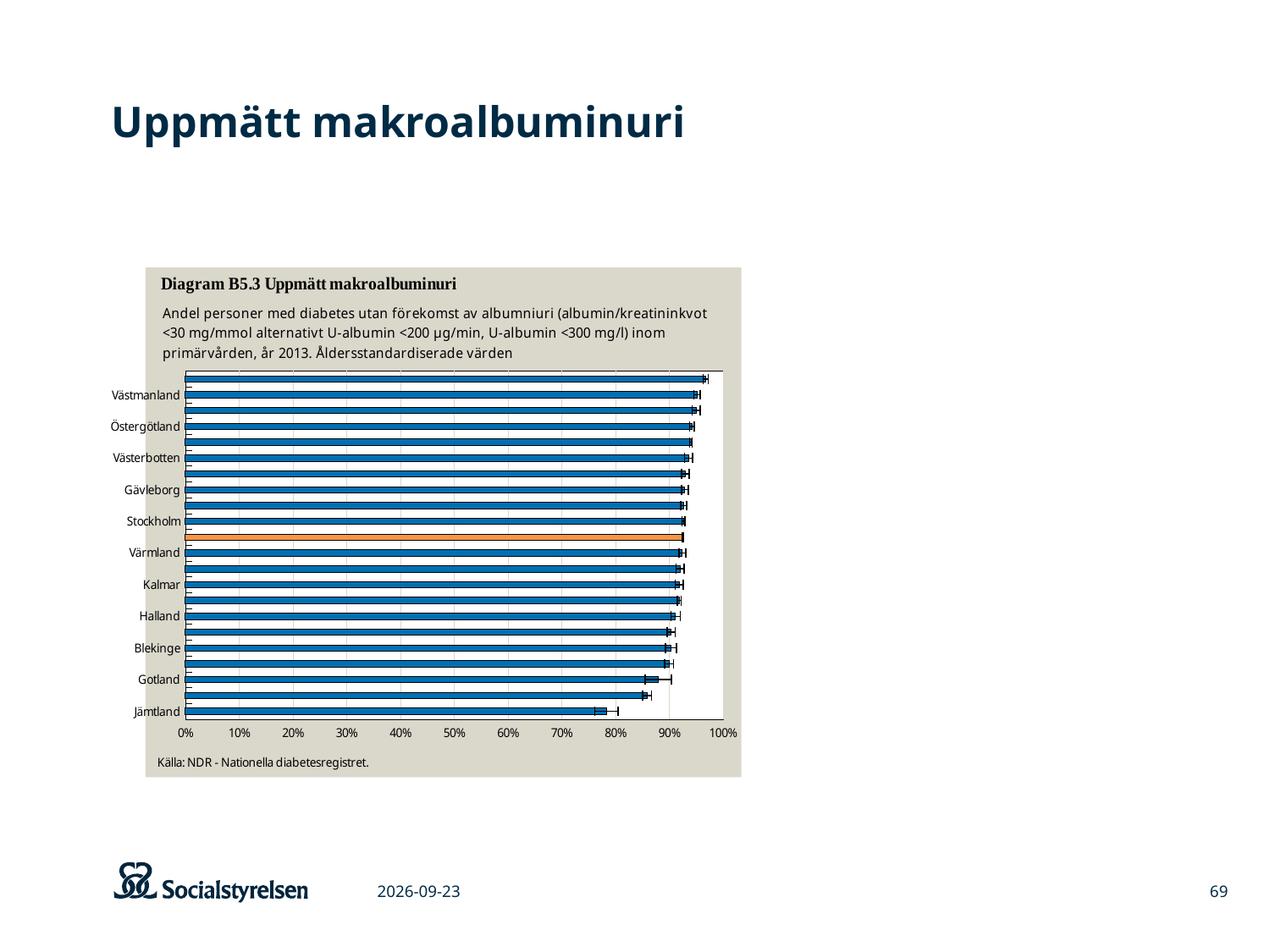
Is the value for Västmanland greater or less than 90%? greater Which has the larger value, Gävleborg or Gotland? Gävleborg What is the title of the diagram shown in the chart box? Diagram B5.3 Uppmätt makroalbuminuri Which labelled region has the lowest value in the chart? Jämtland Do the bar values increase or decrease going from the top of the chart to the bottom? Decrease What kind of chart is shown on the slide? Bar chart What colour is the single bar that differs from the others in the chart? Orange Is the value for Gotland greater or less than 90%? less Which has the larger value, Västmanland or Jämtland? Västmanland Is the value for Stockholm greater or less than 80%? greater